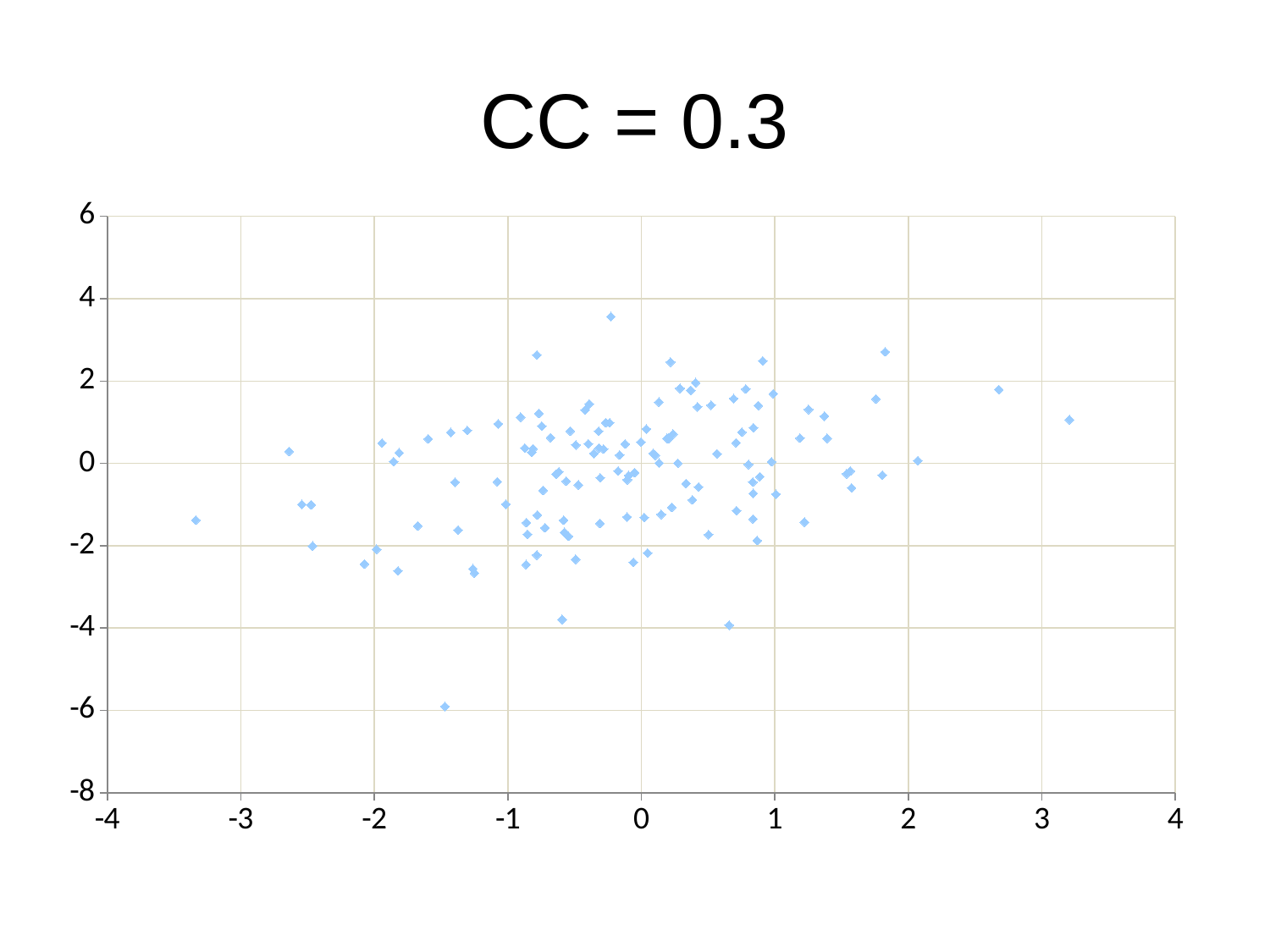
Do the plotted y values tend to rise or fall as x increases? rise What is the title of the chart? CC = 0.3 Is the x value of the leftmost plotted point greater or less than -3? less Is the y value of the lowest plotted point greater or less than -4? less What kind of chart is shown on the slide? scatter chart Is the x value of the lowest plotted point greater or less than -1? less What is the lowest value shown on the y axis? -8